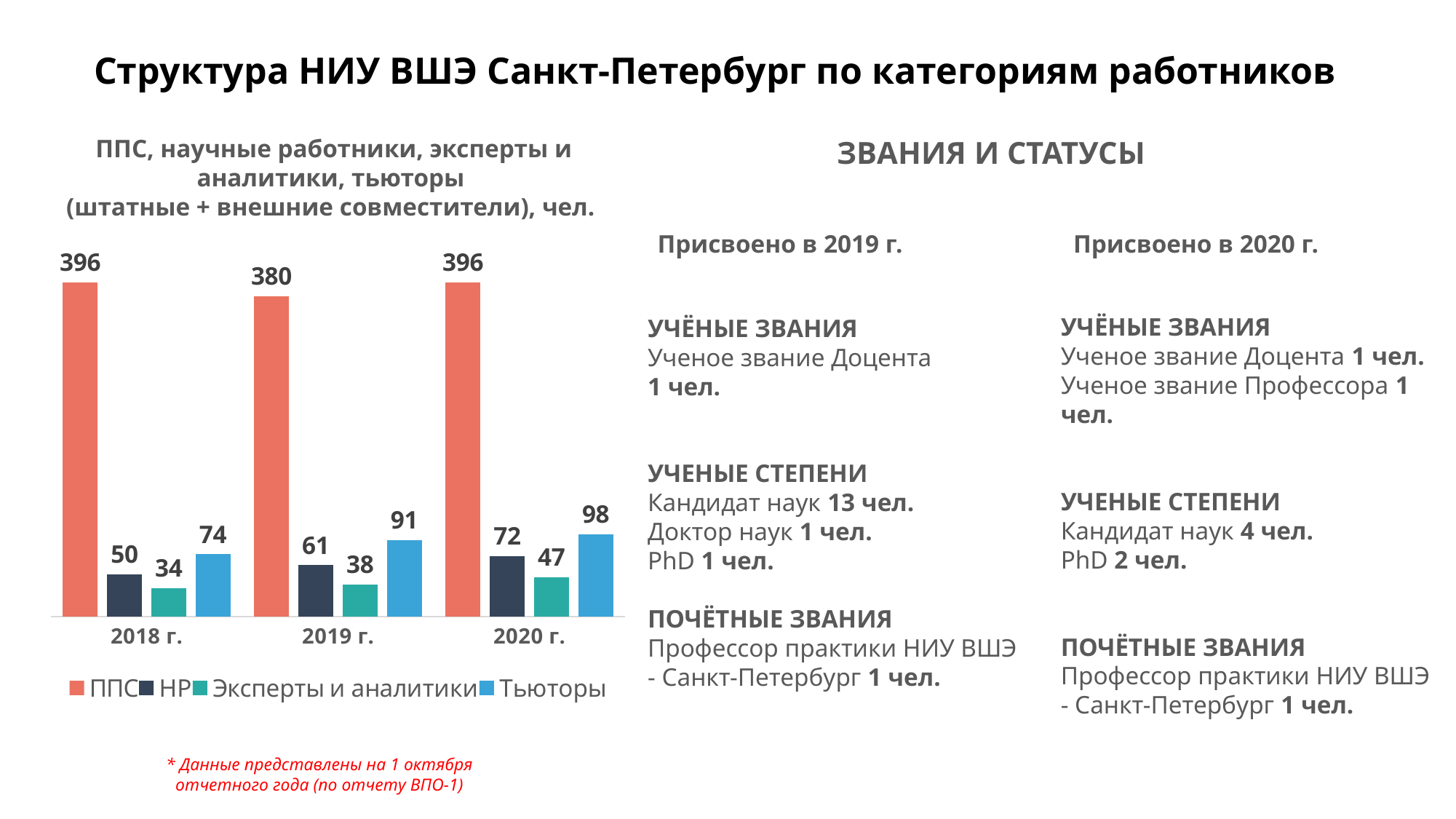
What is the value for Эксперты и аналитики in 2019 г.? 38 How many years are shown on the x axis? 3 How many series does the legend list? 4 What is the value for НР in 2020 г.? 72 Do the Тьюторы values rise or fall from 2018 г. to 2020 г.? Rise In which year is the ППС value lowest? 2019 г. What is the difference between the Тьюторы values in 2020 г. and 2018 г.? 24 Which is larger in 2019 г.: НР or Эксперты и аналитики? НР What is the value for Тьюторы in 2020 г.? 98 What is the value for ППС in 2018 г.? 396 What kind of chart is shown on the slide? Bar chart Which series has the highest value in 2020 г.? ППС